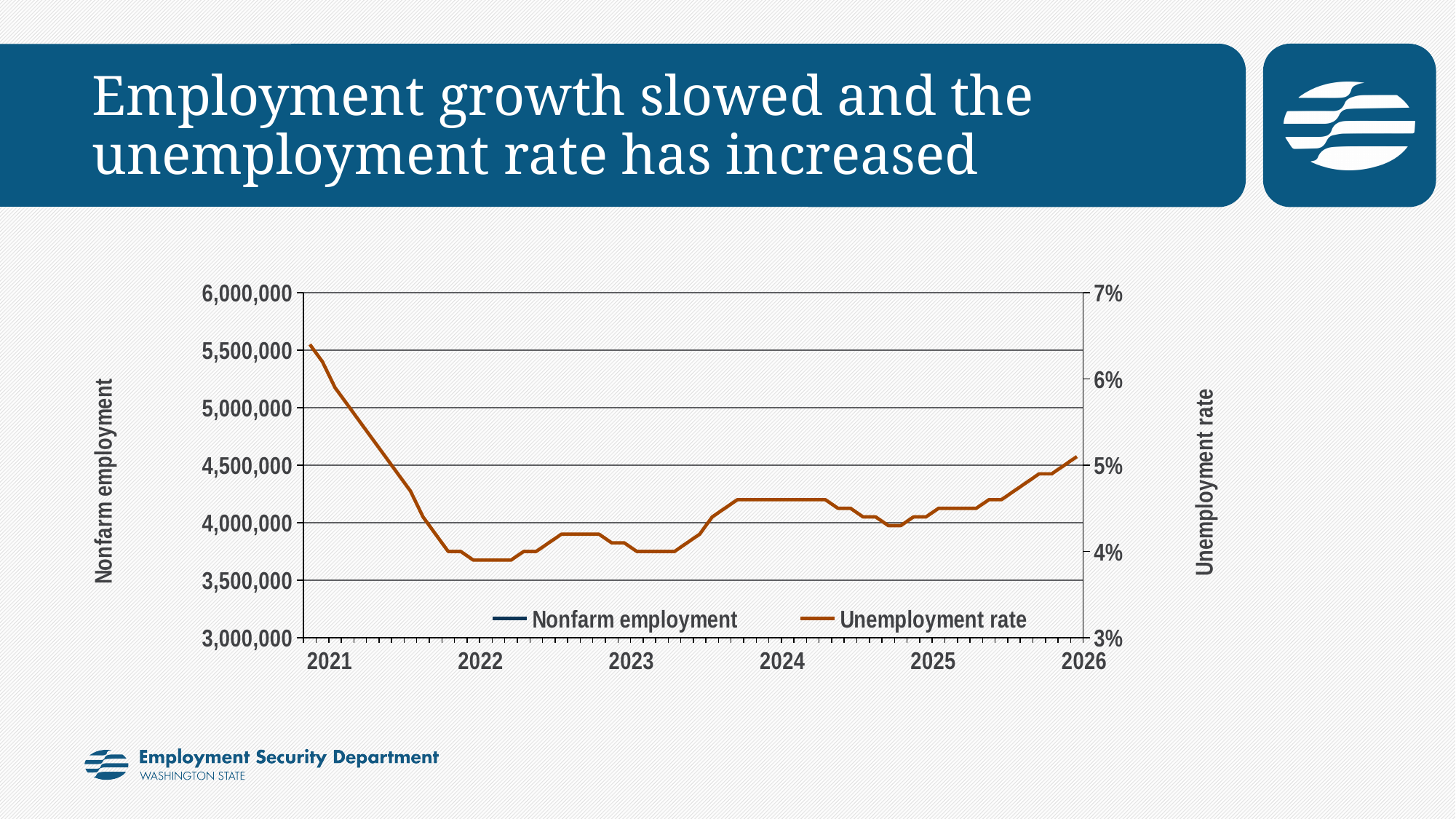
What is the title of the right-hand vertical axis? Unemployment rate Does the unemployment rate rise or fall between 2025 and 2026? rise What are the two series named in the chart legend? Nonfarm employment and Unemployment rate Is the unemployment rate at the start of 2024 greater or less than 4%? greater How many series does the chart legend list? 2 What kind of chart is shown on the slide? line chart Is the unemployment rate at the start of 2024 greater or less than 5%? less In which year labelled on the x axis does the unemployment rate reach its highest point? 2021 Does the unemployment rate rise or fall between 2021 and 2022? fall Is the unemployment rate at the start of 2021 greater or less than 6%? greater How many year labels are shown on the x axis? 6